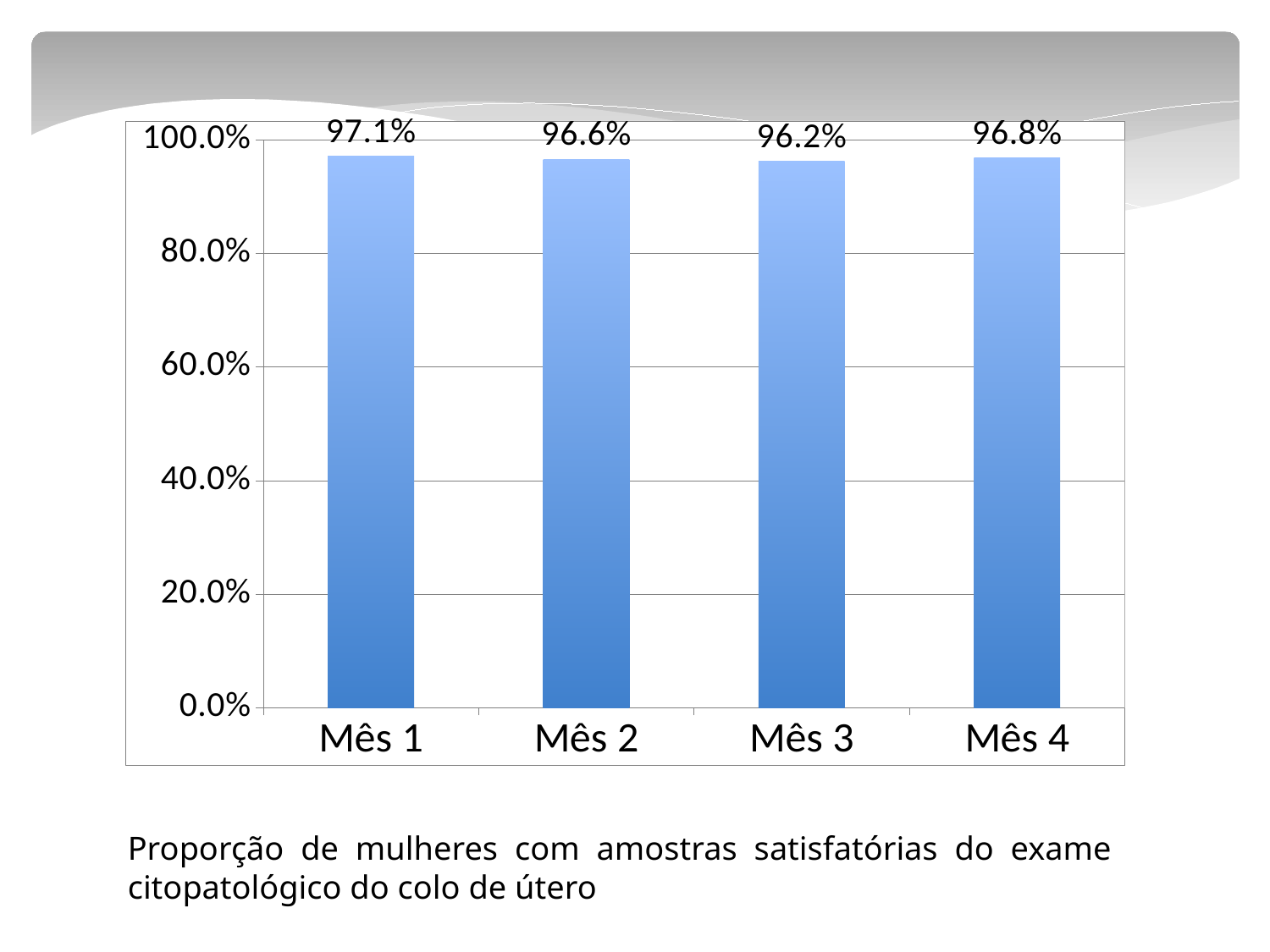
What is the difference between the values for Mês 1 and Mês 3? 0.9% What is the value for Mês 3? 96.2% What is the value for Mês 2? 96.6% Which month has the highest value? Mês 1 What is the value for Mês 4? 96.8% Which month has the lowest value? Mês 3 What is the difference between the values for Mês 4 and Mês 2? 0.2% How many categories are shown on the x axis? 4 What kind of chart is shown on the slide? Bar chart What is the caption text below the chart? Proporção de mulheres com amostras satisfatórias do exame citopatológico do colo de útero Which is larger, the value for Mês 2 or the value for Mês 4? Mês 4 What is the value for Mês 1? 97.1%